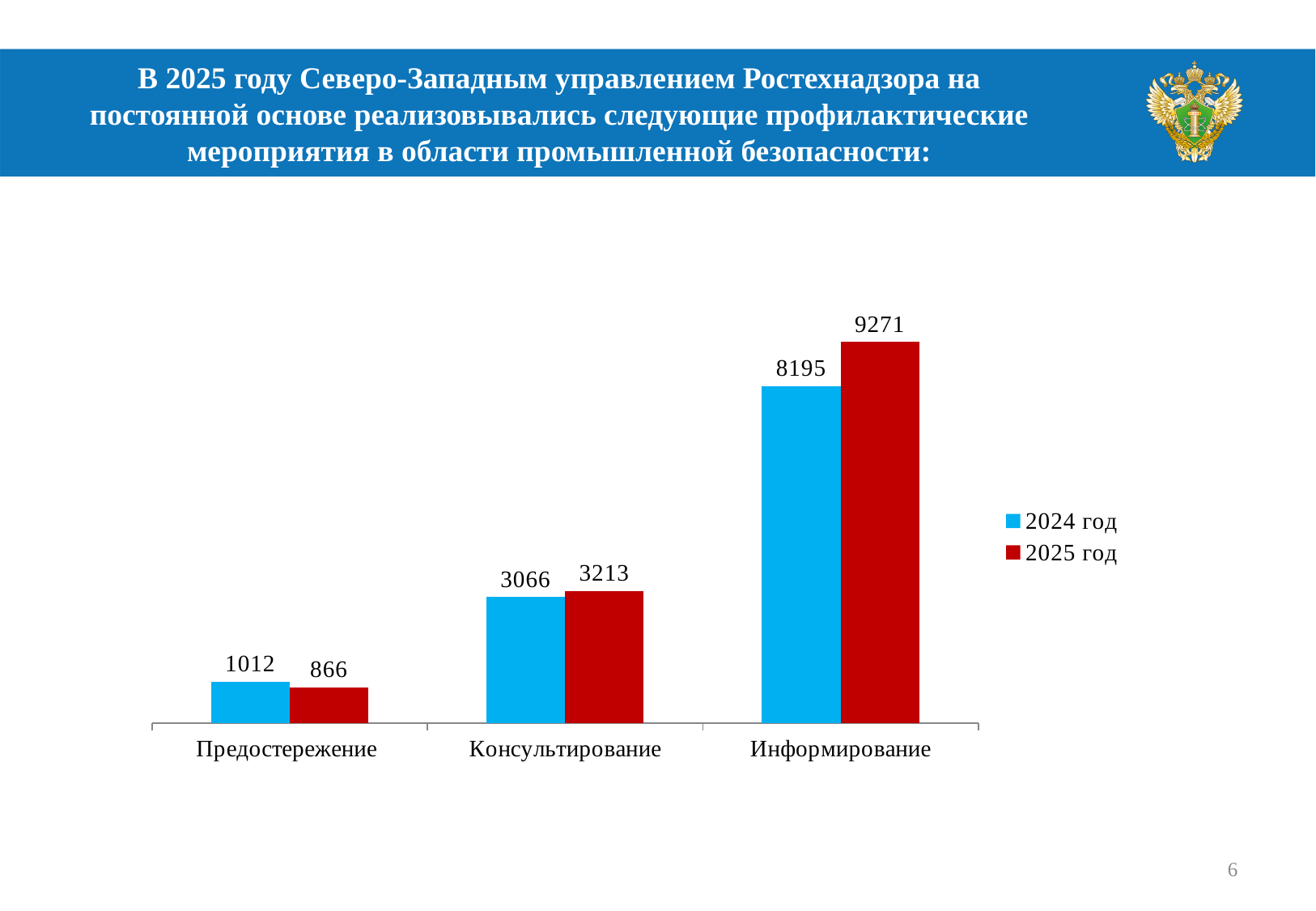
Which category has the lowest value in 2025 год? Предостережение How many series does the legend list? 2 What kind of chart is shown on the slide? Bar chart Which category has the highest value in 2024 год? Информирование What is the value for Информирование in 2025 год? 9271 What is the value for Консультирование in 2025 год? 3213 What is the difference between the 2025 год and 2024 год values for Информирование? 1076 Which is larger for Консультирование: the 2024 год value or the 2025 год value? 2025 год What is the value for Предостережение in 2024 год? 1012 Which is larger for Предостережение: the 2024 год value or the 2025 год value? 2024 год What is the difference between the 2024 год and 2025 год values for Предостережение? 146 How many categories are shown on the x axis? 3